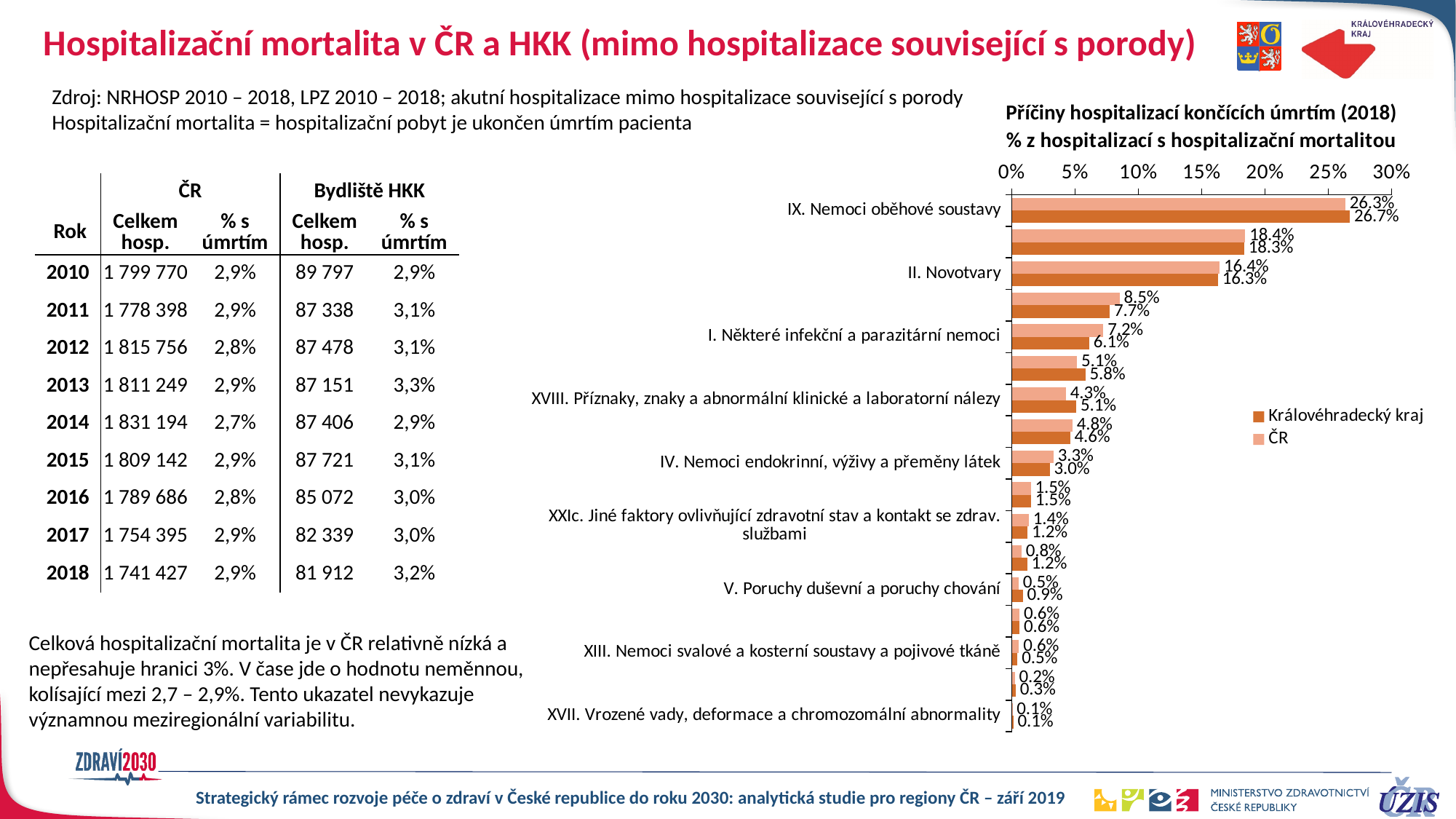
For I. Některé infekční a parazitární nemoci, which is larger: the ČR value or the Královéhradecký kraj value? ČR What is the ČR value for V. Poruchy duševní a poruchy chování? 0.5% How many series does the legend of the chart list? 2 What is the Královéhradecký kraj value for IX. Nemoci oběhové soustavy? 26.7% What is the ČR value for II. Novotvary? 16.4% Which category has the highest values in the chart? IX. Nemoci oběhové soustavy What is the ČR value for IX. Nemoci oběhové soustavy? 26.3% What is the difference between the Královéhradecký kraj and ČR values for IX. Nemoci oběhové soustavy? 0.4 percentage points Which series in the chart is shown in the darker orange colour? Královéhradecký kraj What is the Královéhradecký kraj value for I. Některé infekční a parazitární nemoci? 6.1% What kind of chart is shown on the right side of the slide? bar chart What is the Královéhradecký kraj value for XVIII. Příznaky, znaky a abnormální klinické a laboratorní nálezy? 5.1%